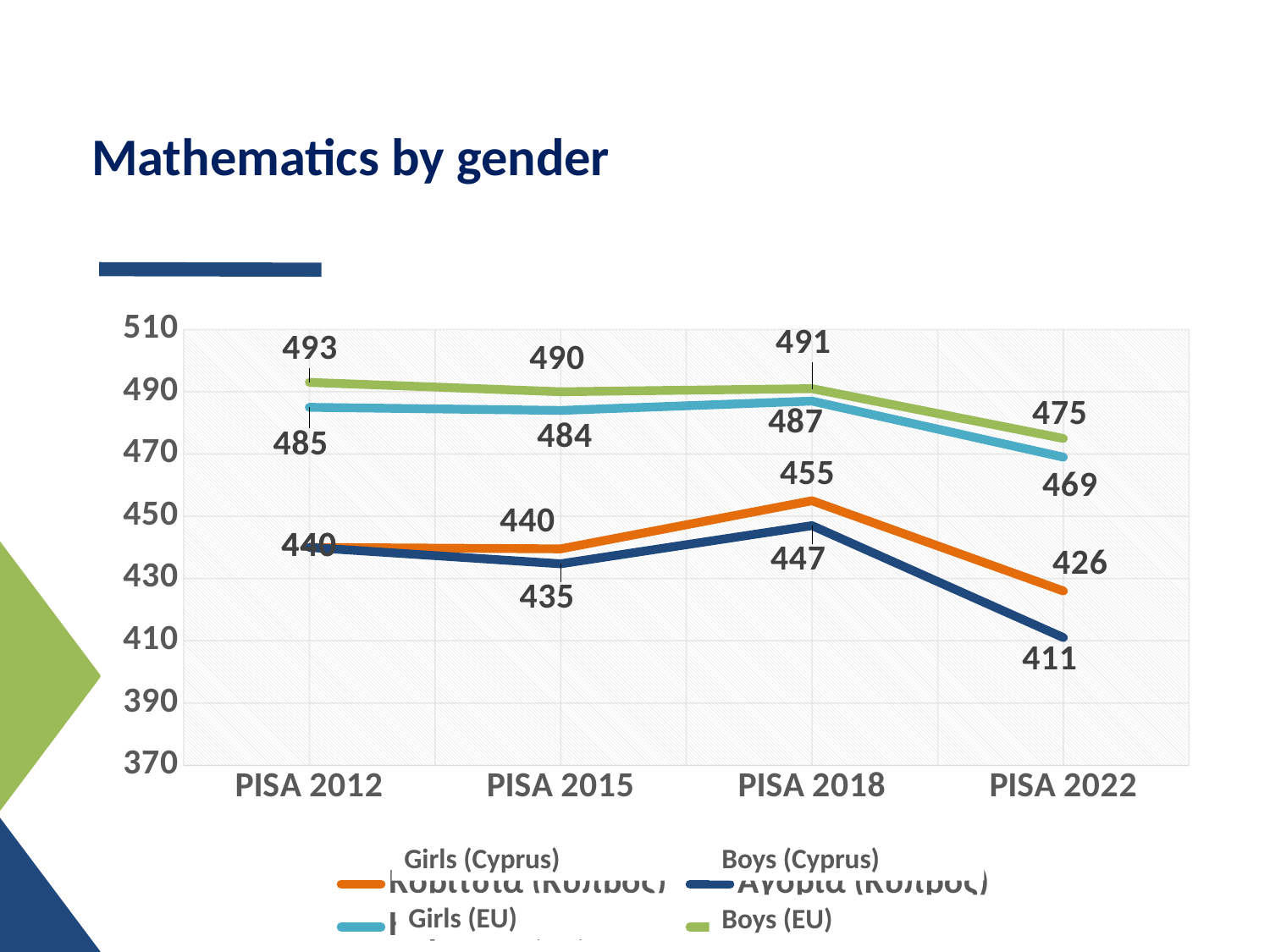
Which is larger in PISA 2015, Girls (Cyprus) or Boys (Cyprus)? Girls (Cyprus) What is the value for Girls (Cyprus) in PISA 2018? 455 Which series has the highest value in PISA 2012? Boys (EU) What is the value for Boys (EU) in PISA 2018? 491 How many series does the legend list? 4 What is the value for Girls (EU) in PISA 2022? 469 How many PISA assessments are shown on the x axis? 4 What is the value for Boys (Cyprus) in PISA 2022? 411 What kind of chart is shown on the slide? Line chart What is the difference between Boys (EU) and Girls (EU) in PISA 2022? 6 In which assessment does Boys (Cyprus) have its lowest value? PISA 2022 What is the difference between Girls (Cyprus) and Boys (Cyprus) in PISA 2018? 8